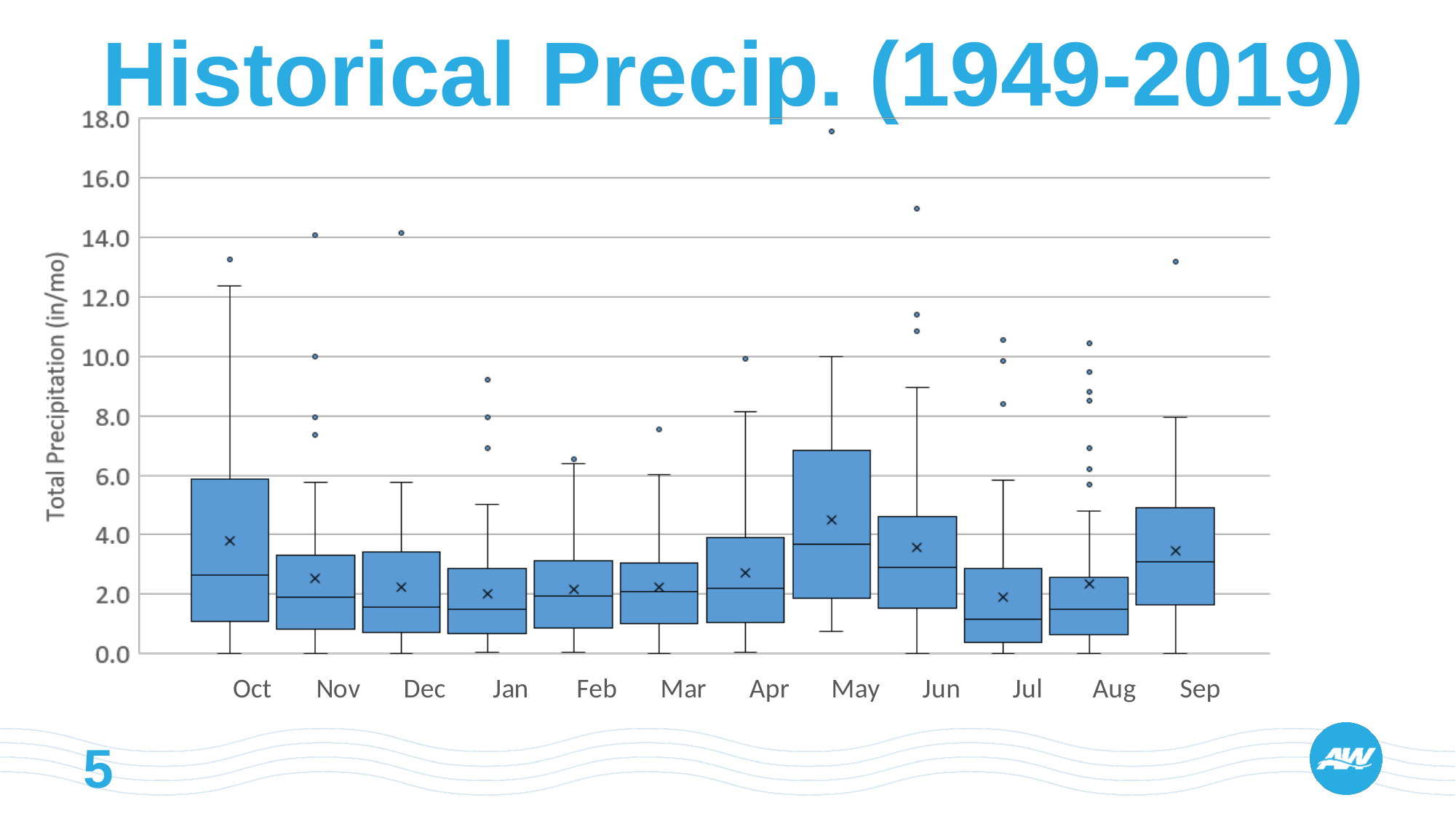
Is the highest outlier for May greater or less than 16.0? greater Which month has the highest median total precipitation? May Is the median value for May greater or less than 2.0? greater Which month has the lowest median total precipitation? Jul Is the median value for Jul greater or less than 2.0? less What is the title of the chart? Historical Precip. (1949-2019) How many months are shown along the x axis? 12 Which month has the highest single outlier point? May Which has the larger median total precipitation, Oct or Nov? Oct What kind of chart is shown on the slide? Box-and-whisker plot What is the label on the y axis? Total Precipitation (in/mo)